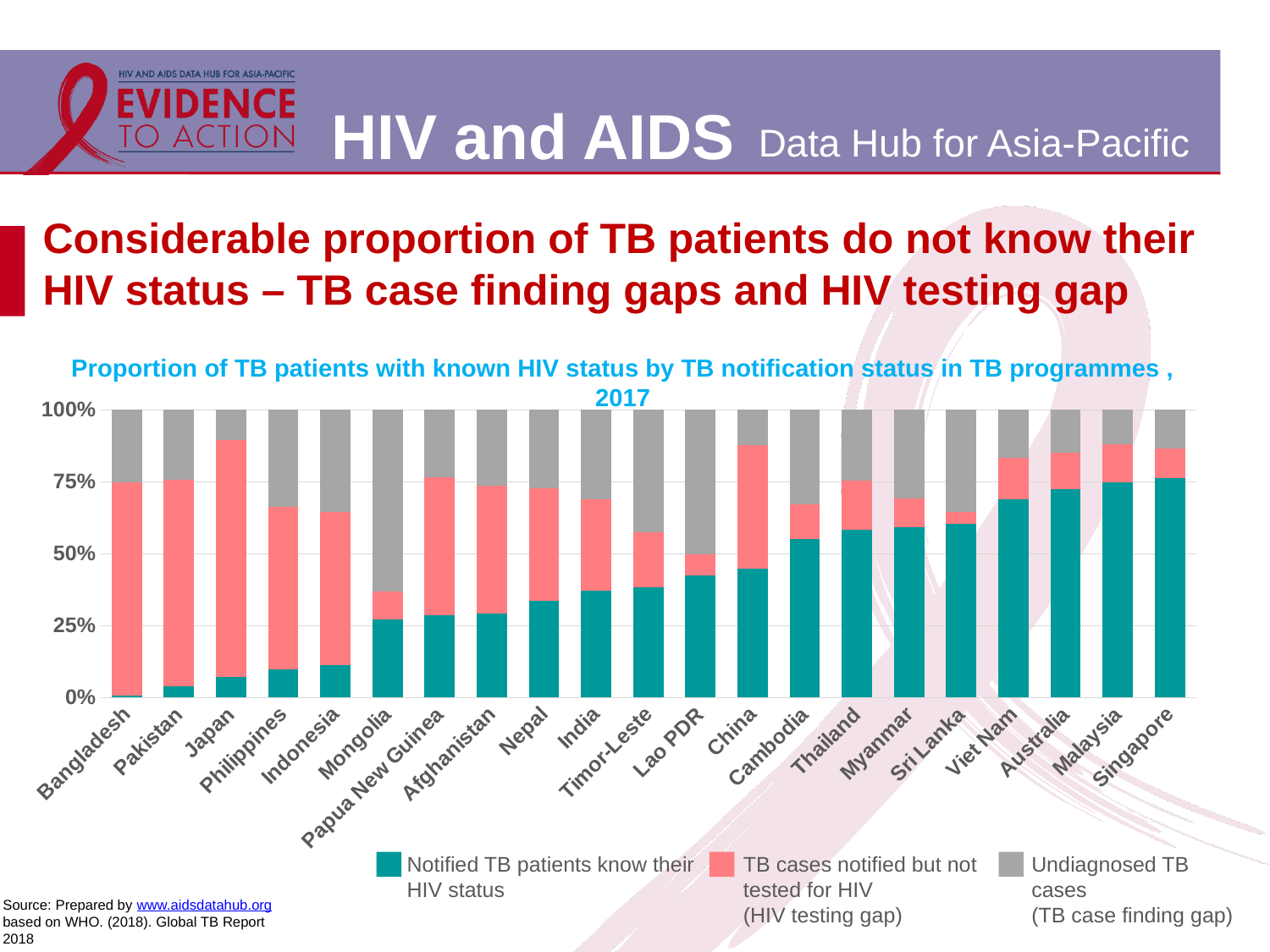
Is the proportion of notified TB patients who know their HIV status in Bangladesh greater or less than 25%? less What kind of chart is shown on the slide? Stacked bar chart How many series does the chart's legend list? 3 Is the proportion of notified TB patients who know their HIV status in Viet Nam greater or less than 50%? greater Is the proportion of notified TB patients who know their HIV status in India greater or less than 50%? less Which country has the largest share of TB cases notified but not tested for HIV (HIV testing gap)? Japan Which year does the chart title say the data refer to? 2017 Which country has the smallest proportion of notified TB patients who know their HIV status? Bangladesh Which country has a larger proportion of notified TB patients who know their HIV status, Japan or Viet Nam? Viet Nam Which country has the largest share of undiagnosed TB cases (TB case finding gap)? Mongolia Moving from left to right along the x axis, does the proportion of notified TB patients who know their HIV status generally rise or fall? Rise How many countries are shown on the x axis of the chart? 21